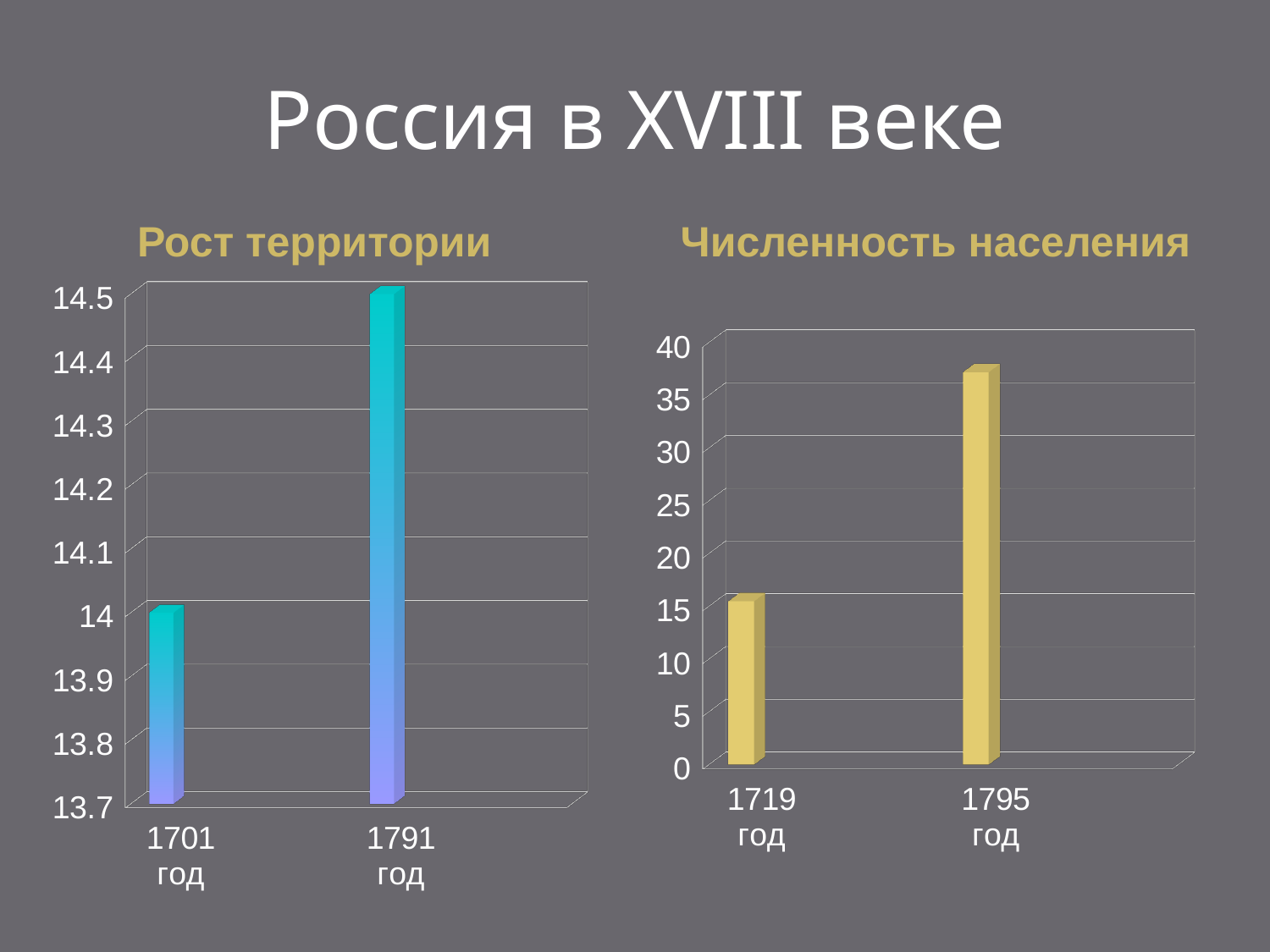
In the chart titled "Рост территории", which category has the highest value? 1791 год In the chart titled "Рост территории", what is the difference between the values for 1791 год and 1701 год? 0.5 In the chart titled "Численность населения", is the value for 1719 год greater or less than 20? less In the chart titled "Численность населения", is the value for 1795 год greater or less than 35? greater In the chart titled "Численность населения", which is larger, the value for 1719 год or 1795 год? 1795 год In the chart titled "Рост территории", what is the value for 1701 год? 14 What kind of chart is the chart titled "Численность населения"? bar chart What is the title of the chart on the left side of the slide? Рост территории In the chart titled "Рост территории", what is the value for 1791 год? 14.5 In the chart titled "Численность населения", which category has the lowest value? 1719 год In the chart titled "Численность населения", do the values rise or fall from 1719 год to 1795 год? rise In the chart titled "Рост территории", how many bars are plotted? 2